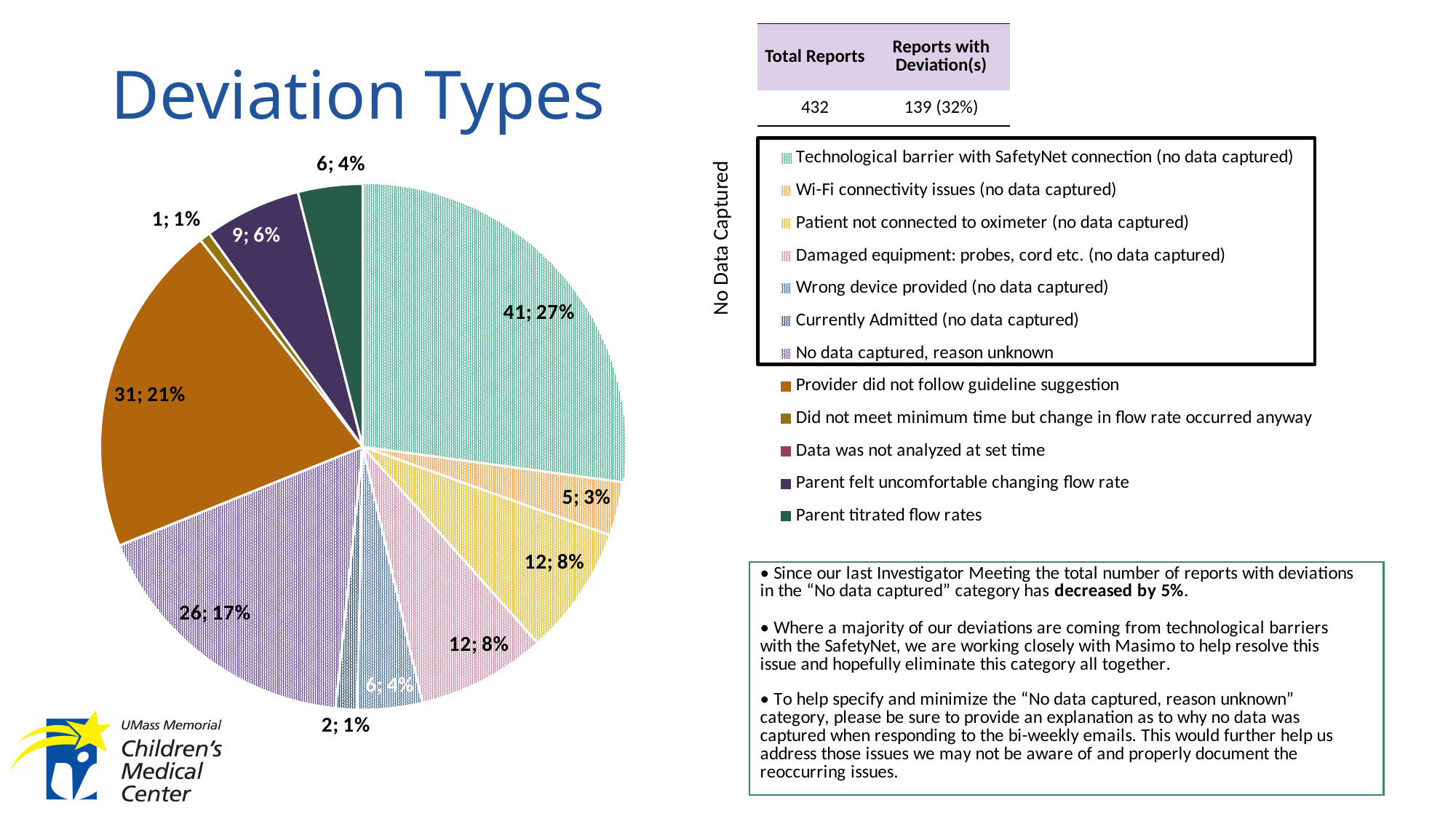
Which has more deviations: 'Parent titrated flow rates' or 'Parent felt uncomfortable changing flow rate'? Parent felt uncomfortable changing flow rate Which deviation type has the largest slice of the pie chart? Technological barrier with SafetyNet connection (no data captured) What count and percentage are shown for the 'Technological barrier with SafetyNet connection' slice? 41; 27% What count and percentage are shown for 'No data captured, reason unknown'? 26; 17% What count and percentage are shown for 'Parent felt uncomfortable changing flow rate'? 9; 6% What count and percentage are shown for 'Currently Admitted (no data captured)'? 2; 1% What share of the pie does 'Wi-Fi connectivity issues (no data captured)' represent? 3% What count and percentage are shown for 'Provider did not follow guideline suggestion'? 31; 21% How many deviation types are listed in the legend? 12 How many more deviations are in 'Technological barrier with SafetyNet connection' than in 'Provider did not follow guideline suggestion'? 10 According to the table on the slide, how many reports had deviations? 139 (32%) What kind of chart is shown on the slide? Pie chart